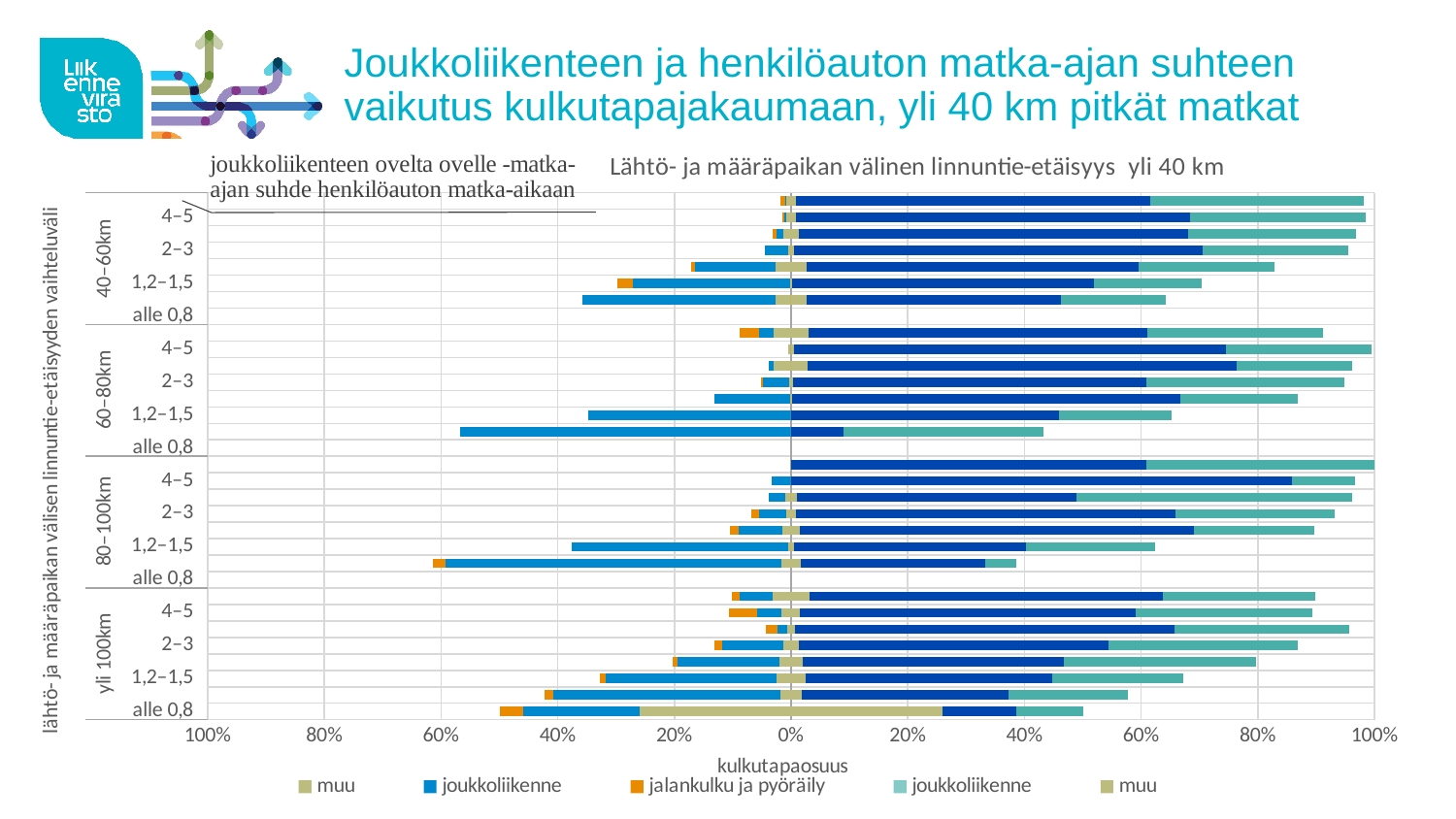
Which extends further to the left: the 'alle 0,8' bar in the yli 100km group or the 'alle 0,8' bar in the 40–60km group? yli 100km In the 40–60km group, does the left-hand bar for '4–5' extend greater or less than 20%? less In the 40–60km group, which extends further to the right: the stacked bar for '4–5' or the stacked bar for 'alle 0,8'? 4–5 What is the title printed above the chart area? Lähtö- ja määräpaikan välinen linnuntie-etäisyys yli 40 km Within the 80–100km group, does the left-hand (blue) bar get longer or shorter moving down from '4–5' to 'alle 0,8'? longer In the 80–100km group, does the right-hand stacked bar for 'alle 0,8' extend greater or less than 60%? less What kind of chart is shown on the slide? bar chart How many entries does the legend list? 5 In the 40–60km group, does the right-hand stacked bar for '4–5' extend greater or less than 80%? greater What is the label of the horizontal axis? kulkutapaosuus How many distance groups are labelled on the vertical axis? 4